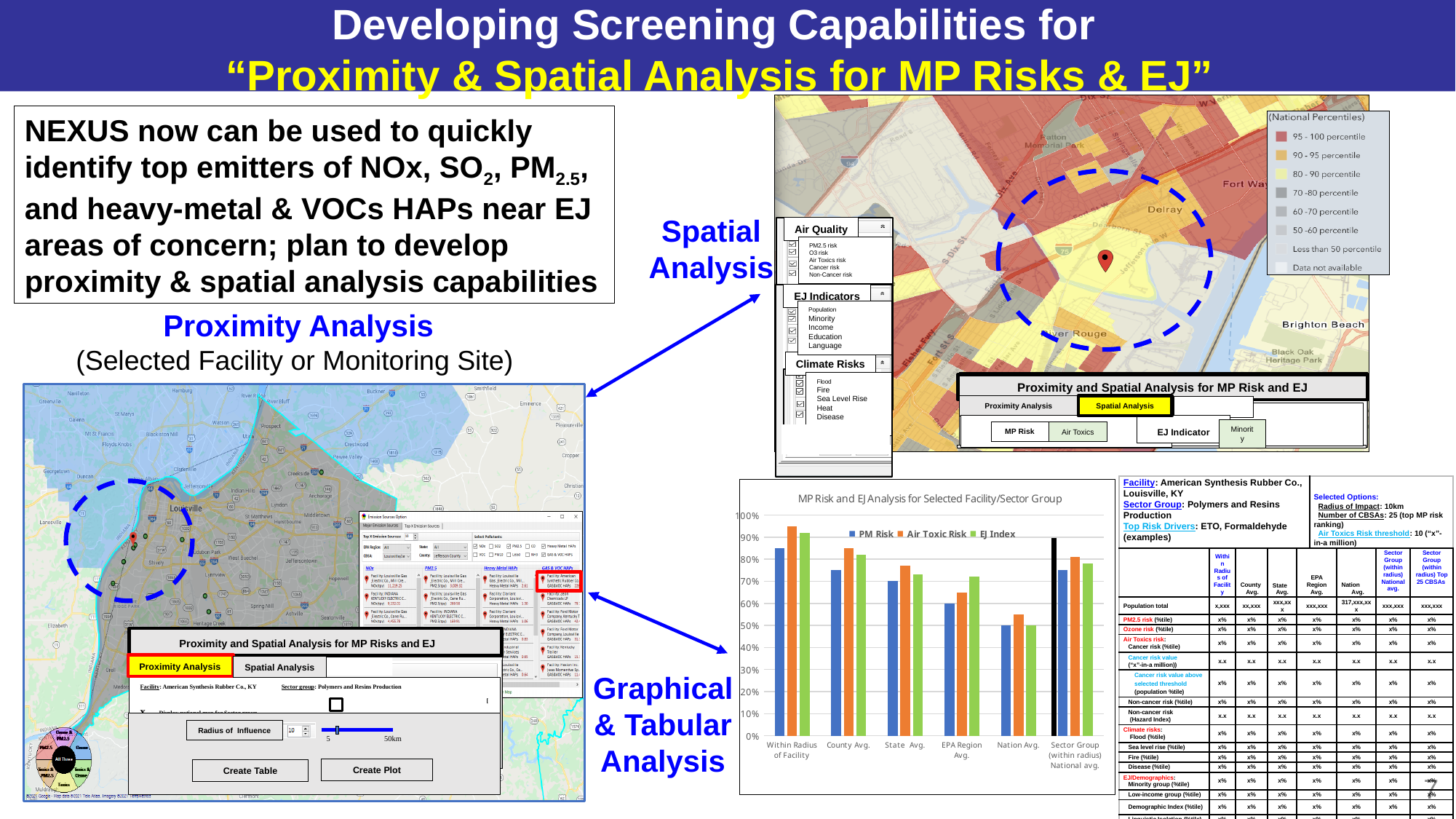
In the 'MP Risk and EJ Analysis' chart, which category has the lowest PM Risk bar? Nation Avg. In the 'MP Risk and EJ Analysis' chart, is the Air Toxic Risk value for Nation Avg. greater or less than 60%? less In the 'MP Risk and EJ Analysis' chart, is the Air Toxic Risk value for Within Radius of Facility greater or less than 90%? greater In the 'MP Risk and EJ Analysis' chart, which is larger: the PM Risk for Within Radius of Facility or the PM Risk for Nation Avg.? Within Radius of Facility In the 'MP Risk and EJ Analysis' chart, which category has the highest Air Toxic Risk bar? Within Radius of Facility What are the three series named in the legend of the 'MP Risk and EJ Analysis' chart? PM Risk, Air Toxic Risk, EJ Index How many series does the legend of the 'MP Risk and EJ Analysis' chart list? 3 What type of chart is used for 'MP Risk and EJ Analysis for Selected Facility/Sector Group'? Bar chart In the 'MP Risk and EJ Analysis' chart, is the PM Risk value for State Avg. greater or less than 80%? less How many categories are shown on the x axis of the 'MP Risk and EJ Analysis' chart? 6 In the 'MP Risk and EJ Analysis' chart, do the PM Risk values rise or fall from Within Radius of Facility through Nation Avg.? fall What is the title of the bar chart on the slide? MP Risk and EJ Analysis for Selected Facility/Sector Group